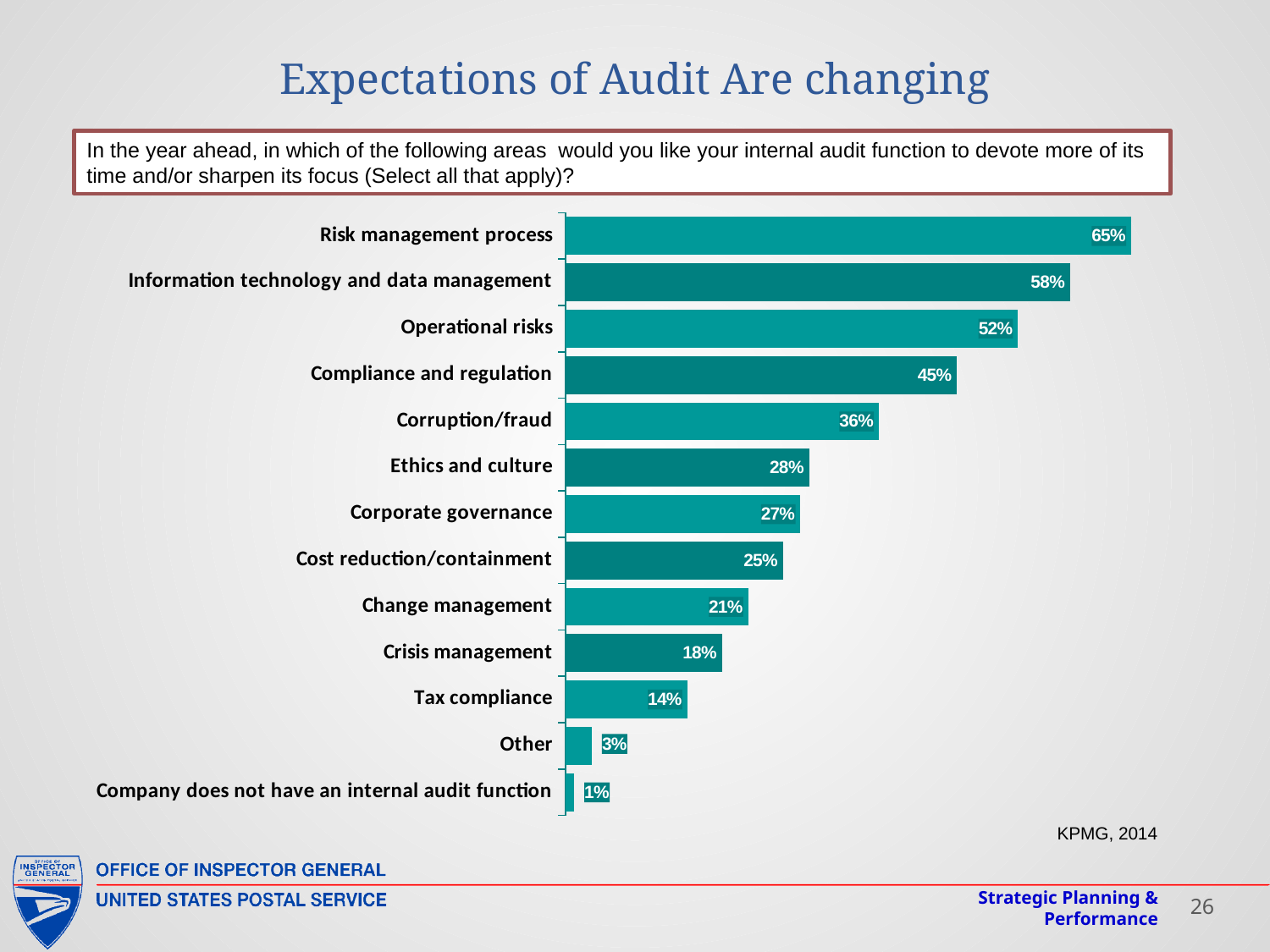
How many categories are shown in the chart? 13 Which is larger, Operational risks or Compliance and regulation? Operational risks What percentage of respondents selected Risk management process? 65% Which category has the lowest value? Company does not have an internal audit function What is the difference between Compliance and regulation and Corruption/fraud? 9% Which category has the highest value? Risk management process What kind of chart is shown on the slide? Bar chart What is the difference between the values for Risk management process and Information technology and data management? 7% What is the value shown for Corruption/fraud? 36% What percentage is shown for Tax compliance? 14% What source is cited for the chart data? KPMG, 2014 Which is larger, the value for Ethics and culture or the value for Cost reduction/containment? Ethics and culture